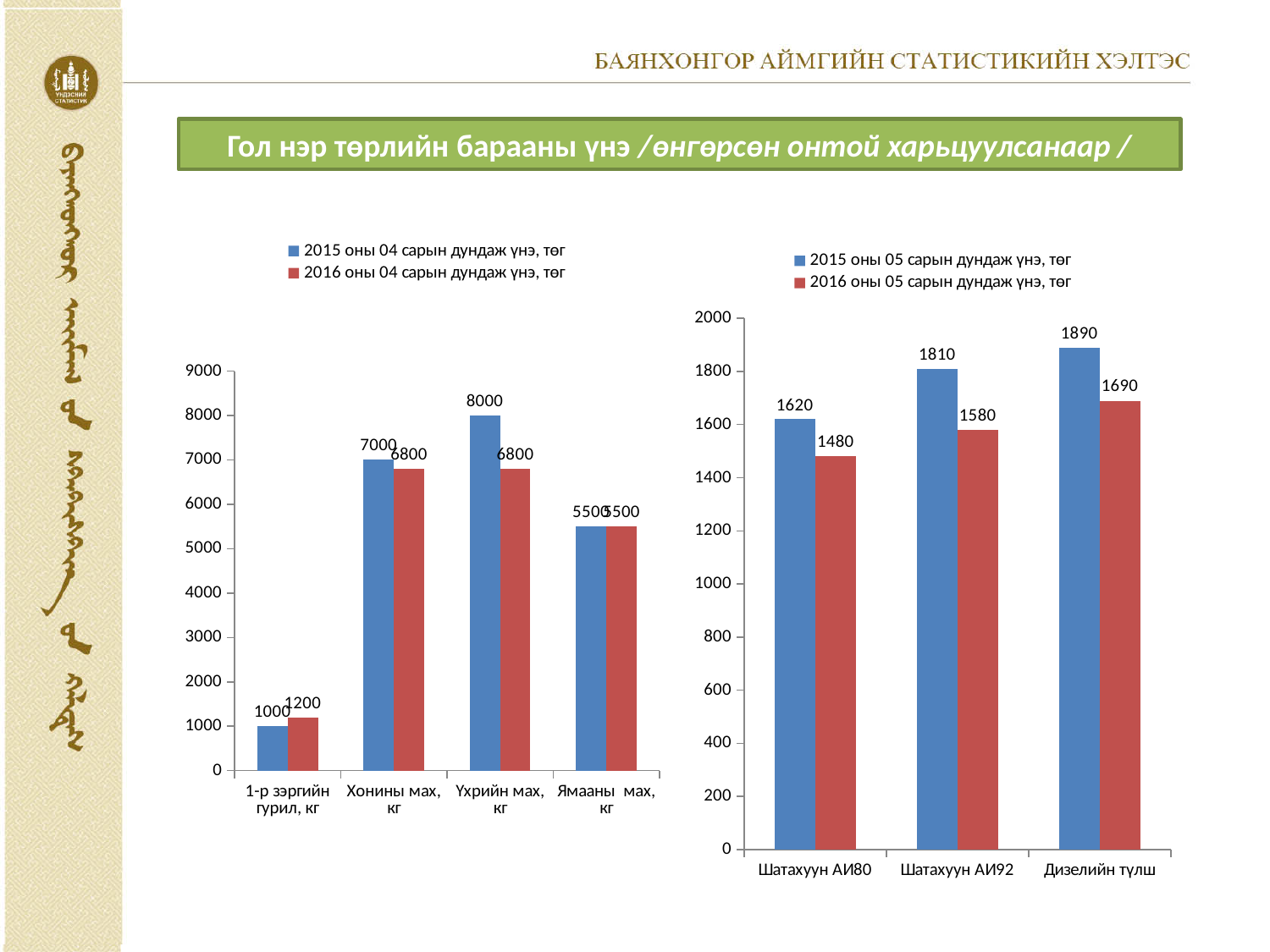
In the left chart, what is the 2015 оны 04 сарын дундаж үнэ for Үхрийн мах, кг? 8000 How many categories are shown on the x axis of the right chart? 3 In the left chart, which category has the lowest 2015 оны 04 сарын дундаж үнэ? 1-р зэргийн гурил, кг In the left chart, which is larger for Хонины мах, кг: the 2015 value or the 2016 value? 2015 value In the right chart, is the 2016 value for Дизелийн түлш greater or less than 1600? greater In the right chart, which category has the highest 2015 оны 05 сарын дундаж үнэ? Дизелийн түлш What kind of chart is the right chart? Bar chart In the left chart, what is the difference between the 2015 and 2016 values for Үхрийн мах, кг? 1200 In the right chart, what is the difference between the 2015 and 2016 values for Шатахуун АИ80? 140 In the left chart, what is the 2016 оны 04 сарын дундаж үнэ for 1-р зэргийн гурил, кг? 1200 In the right chart, what is the 2016 оны 05 сарын дундаж үнэ for Шатахуун АИ92? 1580 How many series does the legend of the left chart list? 2